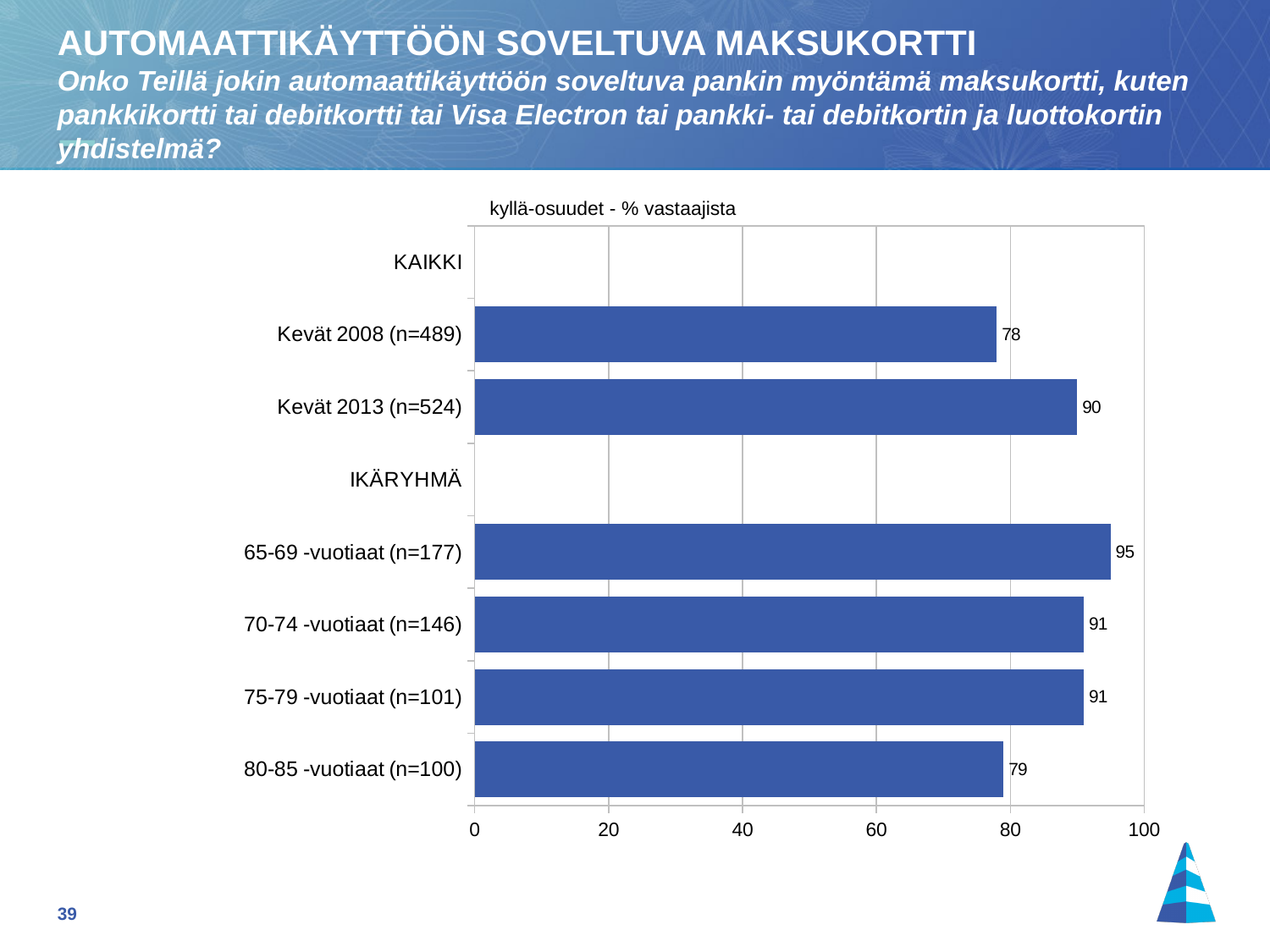
What is the title of the chart? kyllä-osuudet - % vastaajista How many bars are plotted in the chart? 6 What kind of chart is shown on the slide? bar chart Is the value for 70-74 -vuotiaat (n=146) greater or less than 80? greater Which category has the lowest value? Kevät 2008 (n=489) What is the value for Kevät 2013 (n=524)? 90 What is the value for 65-69 -vuotiaat (n=177)? 95 What is the value for Kevät 2008 (n=489)? 78 What is the value for 80-85 -vuotiaat (n=100)? 79 Which is larger, the value for 65-69 -vuotiaat (n=177) or the value for 80-85 -vuotiaat (n=100)? 65-69 -vuotiaat (n=177) What is the difference between the values for Kevät 2013 (n=524) and Kevät 2008 (n=489)? 12 Which category has the highest value? 65-69 -vuotiaat (n=177)